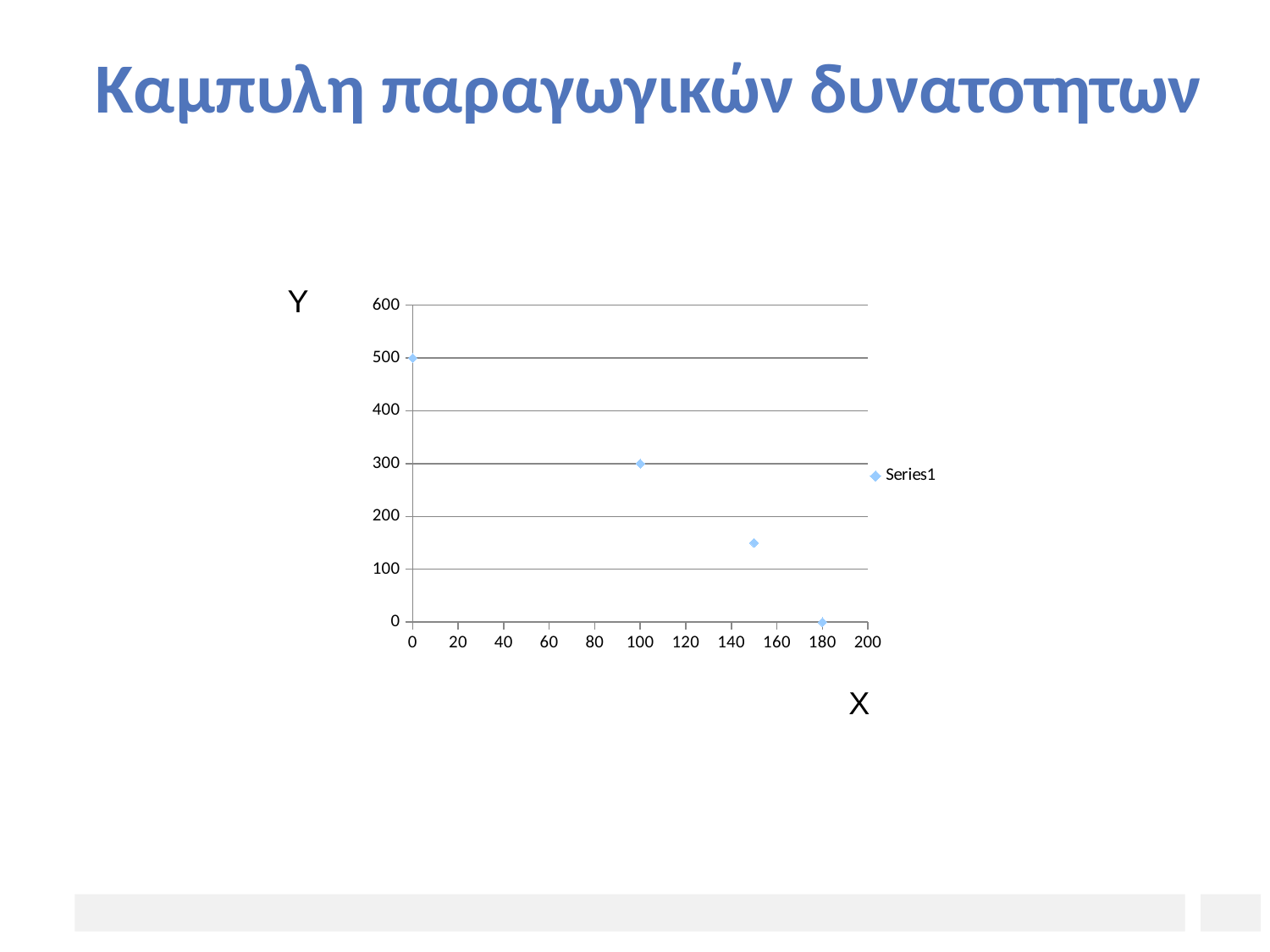
What is the Y value of the point at X = 0? 500 Is the Y value of the point between X = 140 and X = 160 greater or less than 200? less What is the name of the series shown in the legend? Series1 What kind of chart is shown on the slide? scatter chart How many series does the legend list? 1 What is the Y value of the point at X = 100? 300 Do the Y values rise or fall as X increases? fall At which X value does the point with the lowest Y value lie? 180 At which X value does the point with the highest Y value lie? 0 What is the difference between the Y value at X = 0 and the Y value at X = 100? 200 What is the Y value of the point at X = 180? 0 How many data points are plotted in the chart? 4